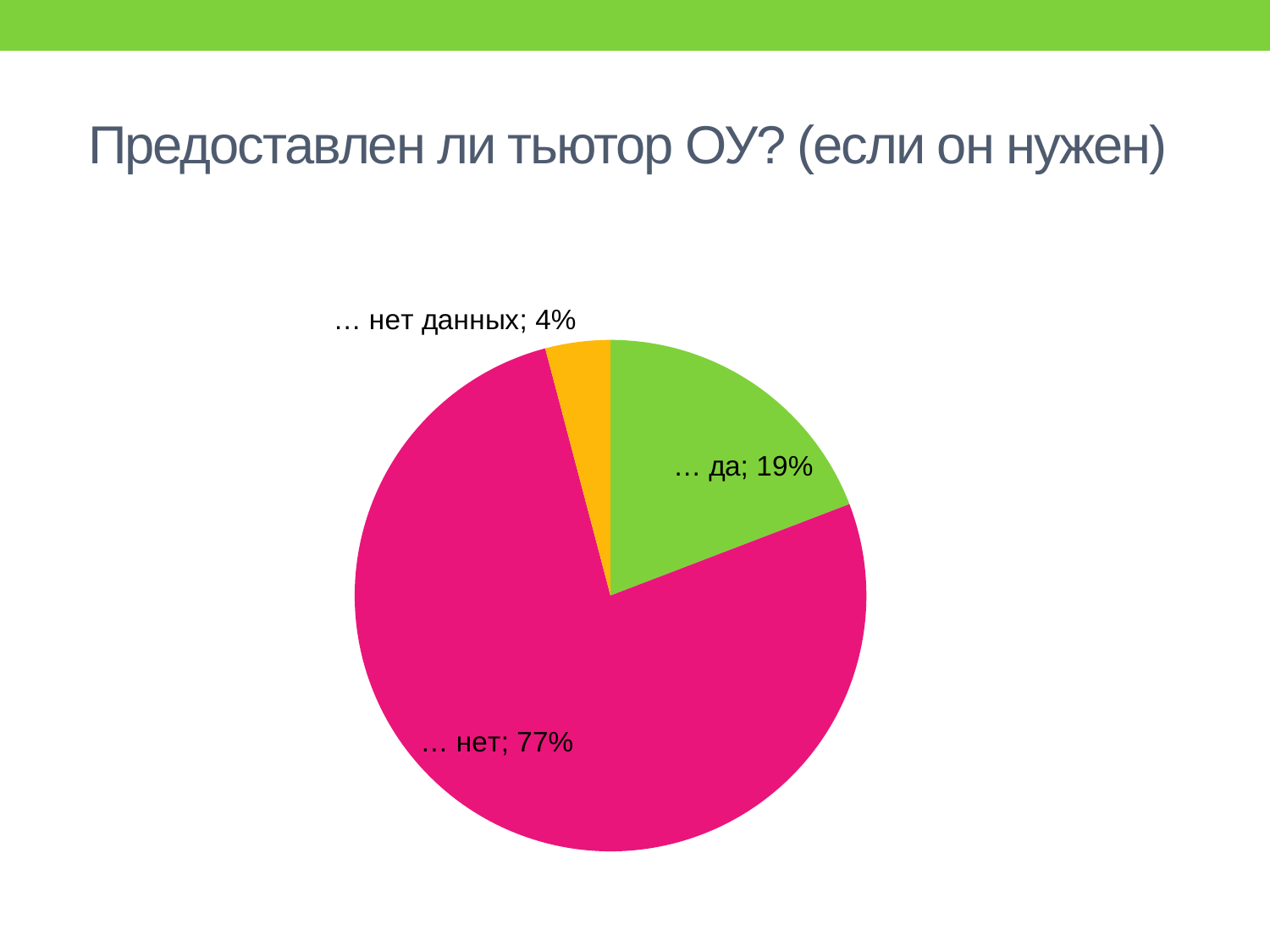
What is the combined share of the "… да" and "… нет данных" slices? 23% What kind of chart is shown on the slide? pie chart Which slice of the pie is the smallest? … нет данных How many slices does the pie chart have? 3 What colour is the "… нет" slice? pink Which slice of the pie is the largest? … нет What is the difference in percentage points between the "… нет" slice and the "… да" slice? 58 What share of the pie is labelled "… нет данных"? 4% What share of the pie is labelled "… нет"? 77% Which is larger, the "… да" slice or the "… нет данных" slice? … да What share of the pie is labelled "… да"? 19% What is the title of the slide? Предоставлен ли тьютор ОУ? (если он нужен)